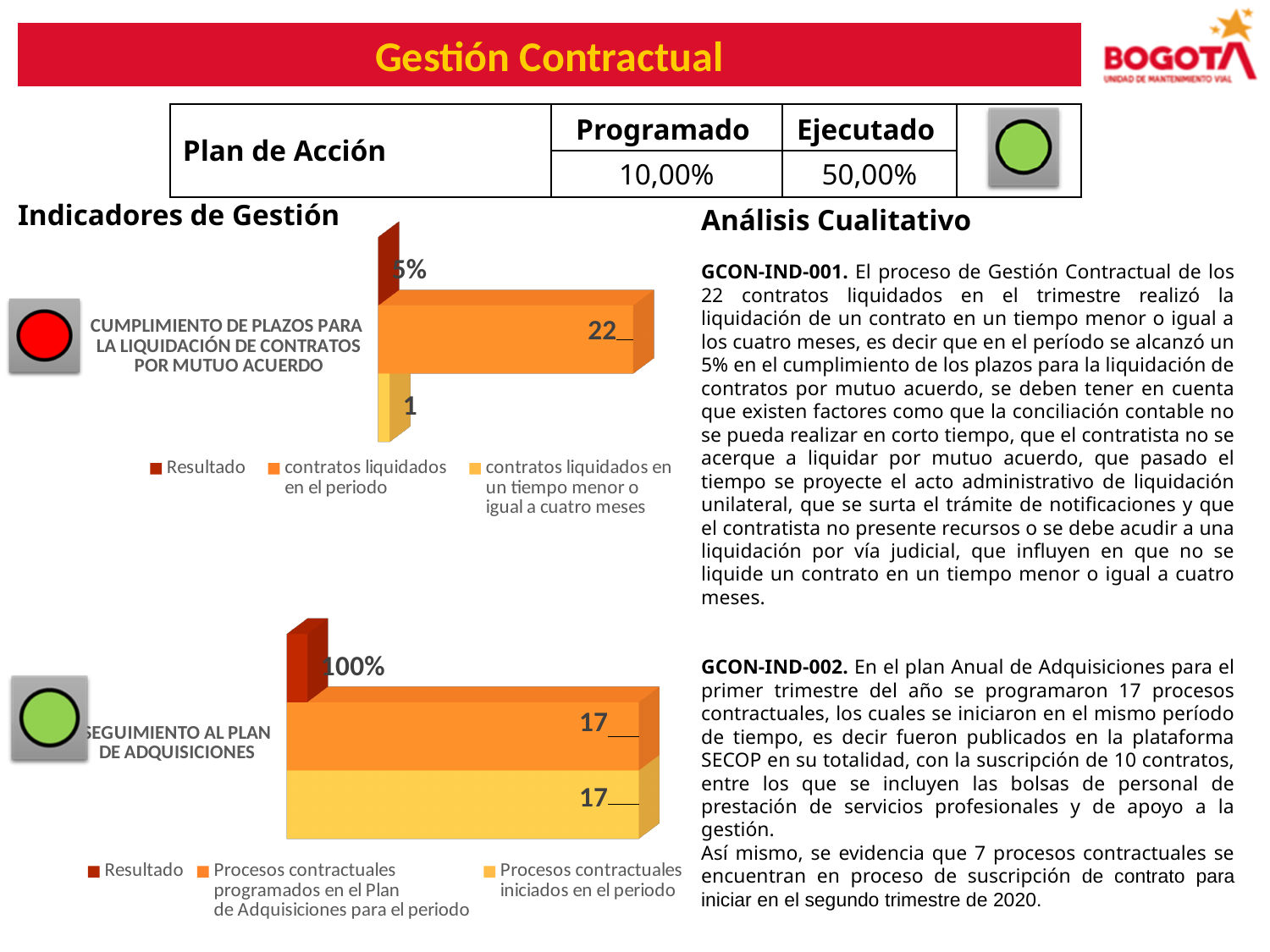
In the top chart (Cumplimiento de plazos para la liquidación de contratos por mutuo acuerdo), what is the difference between 'contratos liquidados en el periodo' and 'contratos liquidados en un tiempo menor o igual a cuatro meses'? 21 In the top chart (Cumplimiento de plazos para la liquidación de contratos por mutuo acuerdo), what is the value for 'contratos liquidados en un tiempo menor o igual a cuatro meses'? 1 In the bottom chart (Seguimiento al plan de adquisiciones), what is the difference between 'Procesos contractuales programados en el Plan de Adquisiciones para el periodo' and 'Procesos contractuales iniciados en el periodo'? 0 In the top chart (Cumplimiento de plazos para la liquidación de contratos por mutuo acuerdo), what is the value labelled for 'Resultado'? 5% What kind of chart is the bottom chart (Seguimiento al plan de adquisiciones)? Bar chart In the top chart (Cumplimiento de plazos para la liquidación de contratos por mutuo acuerdo), what is the value for 'contratos liquidados en el periodo'? 22 In the top chart (Cumplimiento de plazos para la liquidación de contratos por mutuo acuerdo), which is larger: 'contratos liquidados en el periodo' or 'contratos liquidados en un tiempo menor o igual a cuatro meses'? contratos liquidados en el periodo How many series does the legend of the bottom chart (Seguimiento al plan de adquisiciones) list? 3 How many series does the legend of the top chart (Cumplimiento de plazos para la liquidación de contratos por mutuo acuerdo) list? 3 In the bottom chart (Seguimiento al plan de adquisiciones), what is the value for 'Procesos contractuales iniciados en el periodo'? 17 In the bottom chart (Seguimiento al plan de adquisiciones), what is the value labelled for 'Resultado'? 100% In the bottom chart (Seguimiento al plan de adquisiciones), what is the value for 'Procesos contractuales programados en el Plan de Adquisiciones para el periodo'? 17